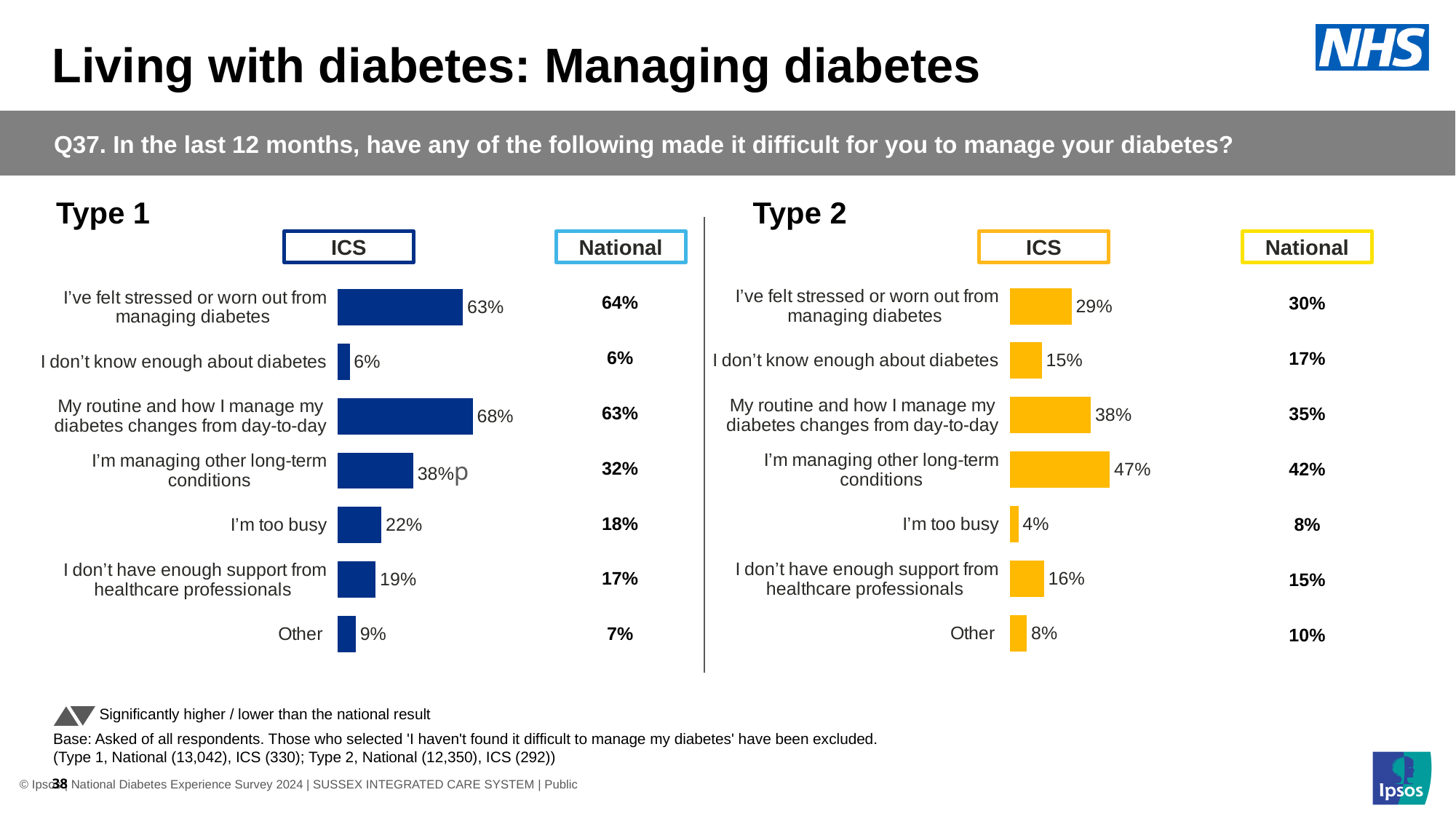
In the Type 2 chart, which is larger for 'I'm too busy': the ICS value or the National value? National In the Type 2 chart, what is the National value for 'I don't know enough about diabetes'? 17% In the Type 1 chart, which category has the highest ICS value? My routine and how I manage my diabetes changes from day-to-day What type of chart is used for the ICS values in the Type 1 chart? Bar chart In the Type 1 chart, what is the difference between the ICS and National values for 'I'm managing other long-term conditions'? 6 percentage points In the Type 2 chart, what is the difference between the ICS and National values for 'Other'? 2 percentage points In the Type 2 chart, which category has the lowest ICS value? I'm too busy In the Type 1 chart, what is the National value for 'I'm too busy'? 18% In the Type 1 chart, what is the ICS value for 'I've felt stressed or worn out from managing diabetes'? 63% In the Type 1 chart, is the ICS value for 'I'm too busy' greater or less than the ICS value for 'I don't have enough support from healthcare professionals'? greater In the Type 2 chart, what is the ICS value for 'I'm managing other long-term conditions'? 47% How many categories are shown in the Type 2 chart? 7